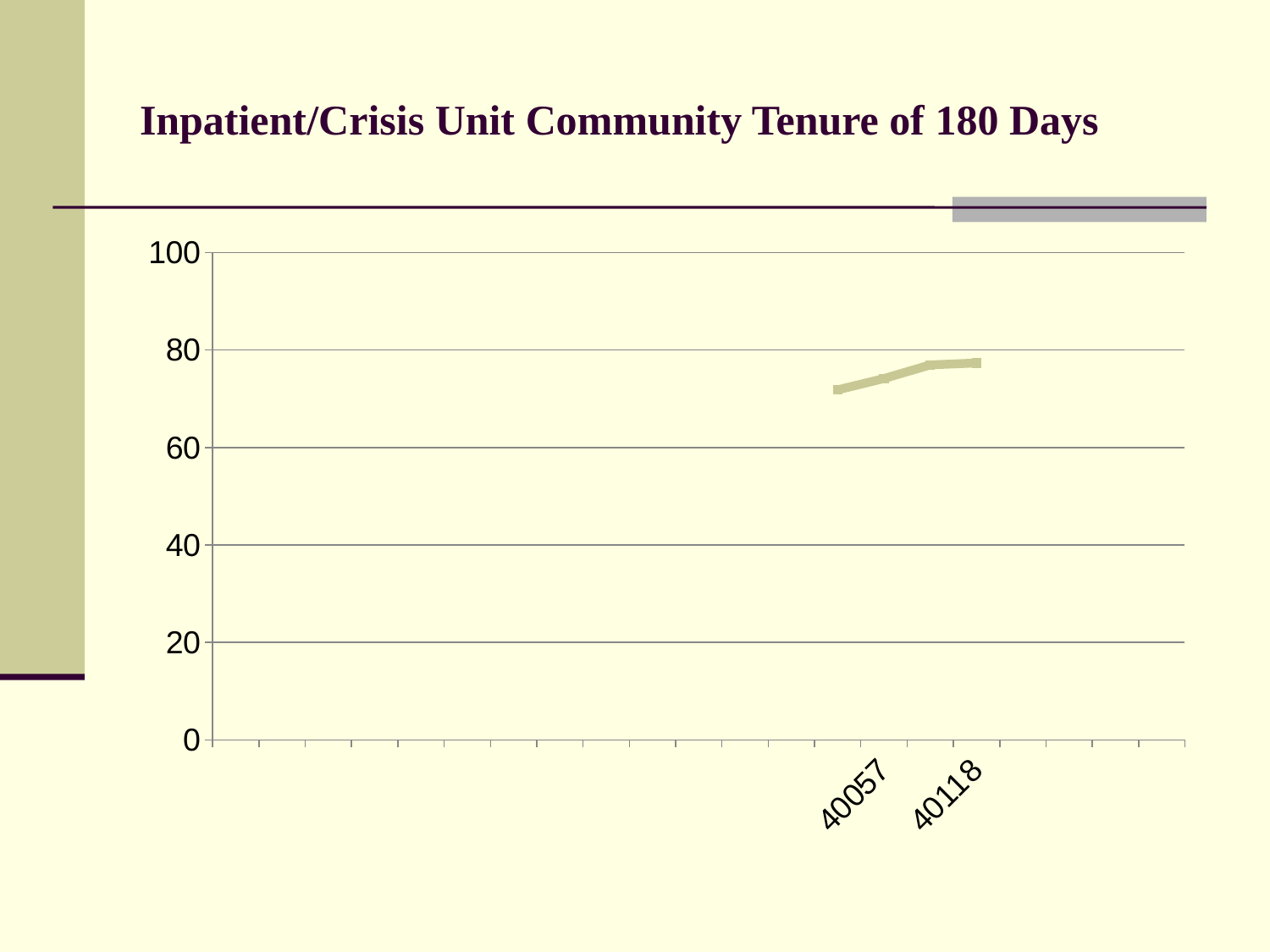
What is the highest value shown on the vertical axis? 100 Is the value for 40118 greater or less than 60? greater What kind of chart is shown on the slide? line chart Is the value for 40118 greater or less than 80? less What is the title of the chart? Inpatient/Crisis Unit Community Tenure of 180 Days Is the value for 40057 greater or less than 80? less Do the plotted values rise or fall from 40057 to 40118? rise Which has the higher value, 40057 or 40118? 40118